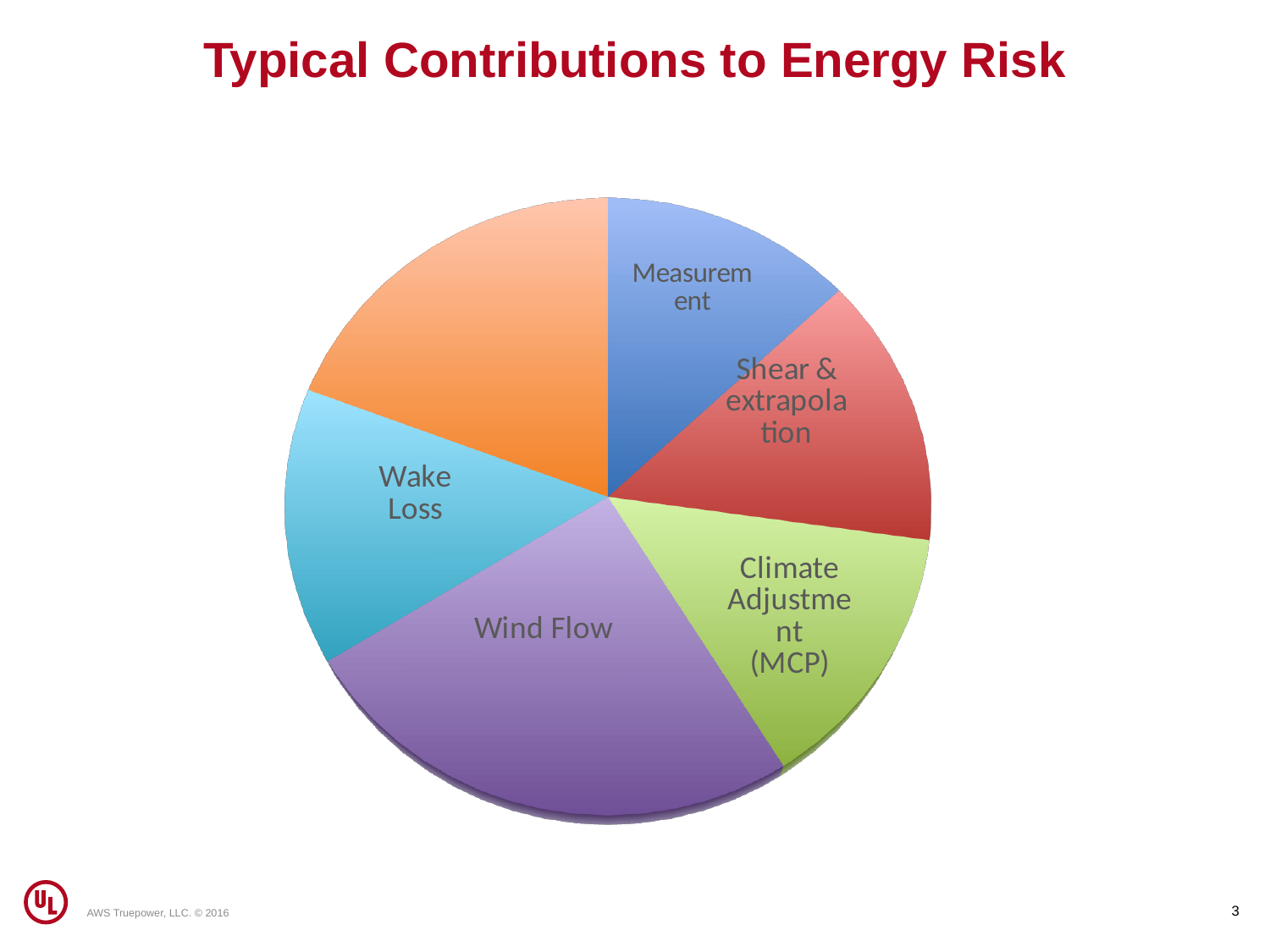
Which slice is larger, Wind Flow or Wake Loss? Wind Flow Which slice is larger, Wind Flow or Climate Adjustment (MCP)? Wind Flow Which slice of the pie chart is the largest? Wind Flow What kind of chart is shown on the slide? pie chart What is the title of the chart? Typical Contributions to Energy Risk Which slice is larger, Wind Flow or Shear & extrapolation? Wind Flow How many slices does the pie chart have? 6 What colour is the Wind Flow slice? purple